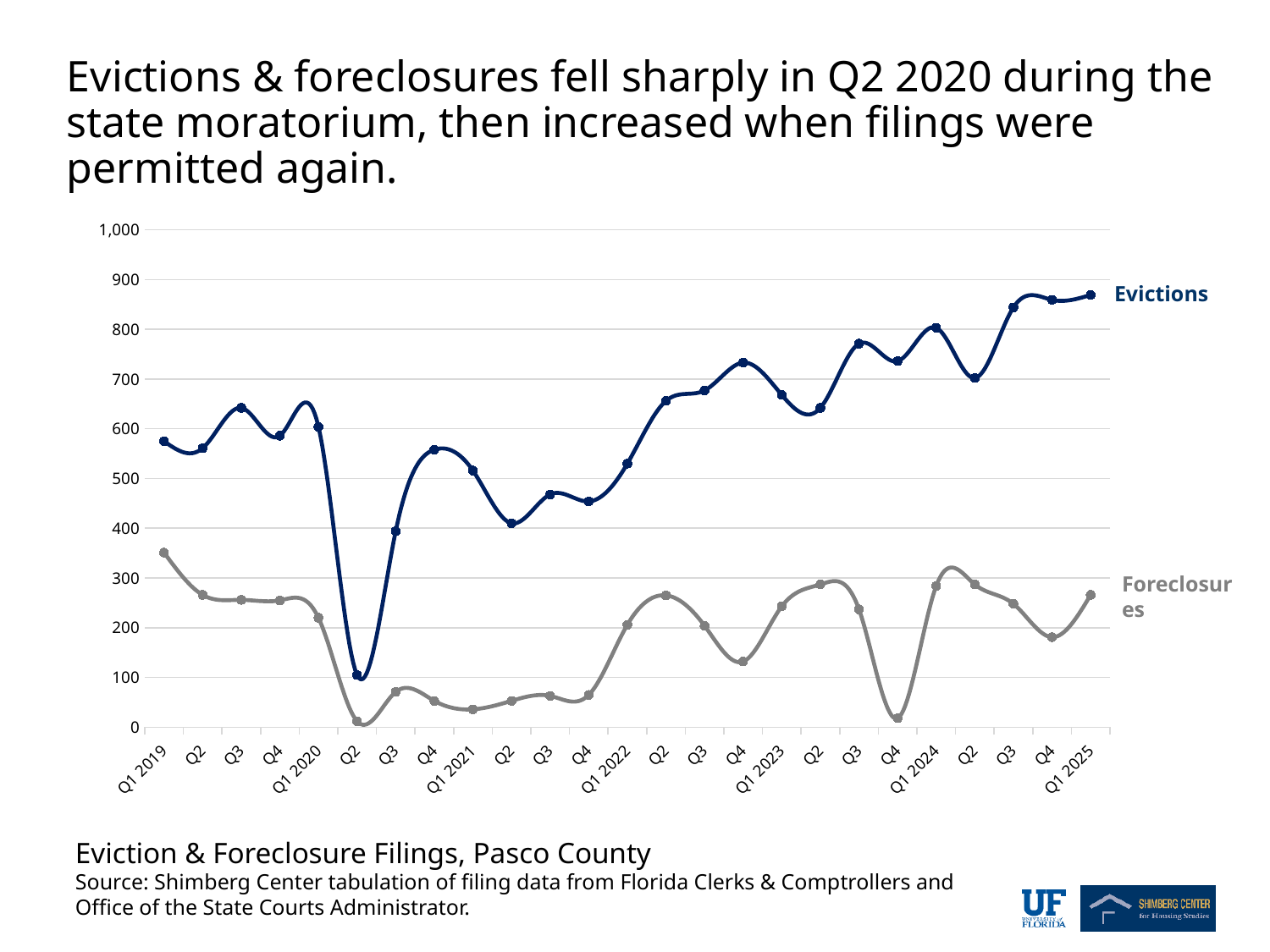
How many quarterly data points does each line have on the chart? 25 Which series has the higher value in Q1 2025, Evictions or Foreclosures? Evictions Is the value for Foreclosures in Q2 2020 greater or less than 100? less Do Evictions generally rise or fall from Q2 2020 to Q1 2025? rise Is the value for Evictions in Q1 2019 greater or less than 500? greater How many series are plotted on the chart? 2 What kind of chart is shown on the slide? line chart Is the value for Evictions in Q2 2020 greater or less than 200? less In which quarter do Evictions reach their lowest value? Q2 2020 What is the title of the chart given below it? Eviction & Foreclosure Filings, Pasco County